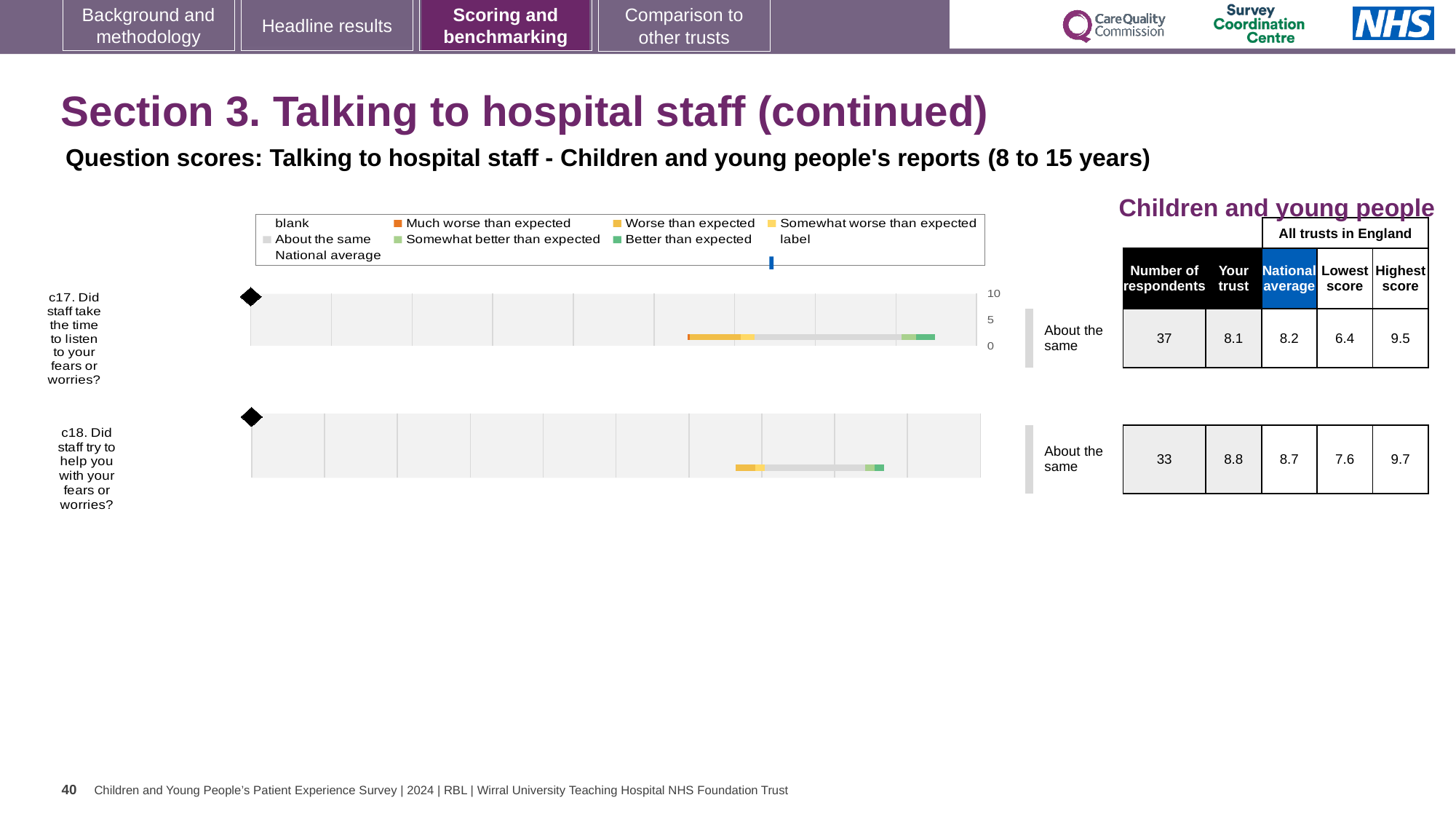
For question c17, what is the Highest score among all trusts in England? 9.5 How many questions are plotted on the slide? 2 For question c18, what is the difference between the Highest score and the Lowest score? 2.1 For question c18, what is the Lowest score among all trusts in England? 7.6 What benchmark category is shown for question c18? About the same For question c17 (Did staff take the time to listen to your fears or worries?), what is the score for Your trust? 8.1 What colour in the legend represents 'Much worse than expected'? orange For question c17, is the Your trust score larger or smaller than the National average? smaller Which question has the higher Your trust score, c17 or c18? c18 What kind of chart is used to show the question scores? bar chart For question c18 (Did staff try to help you with your fears or worries?), what is the National average score? 8.7 How many respondents answered question c17? 37